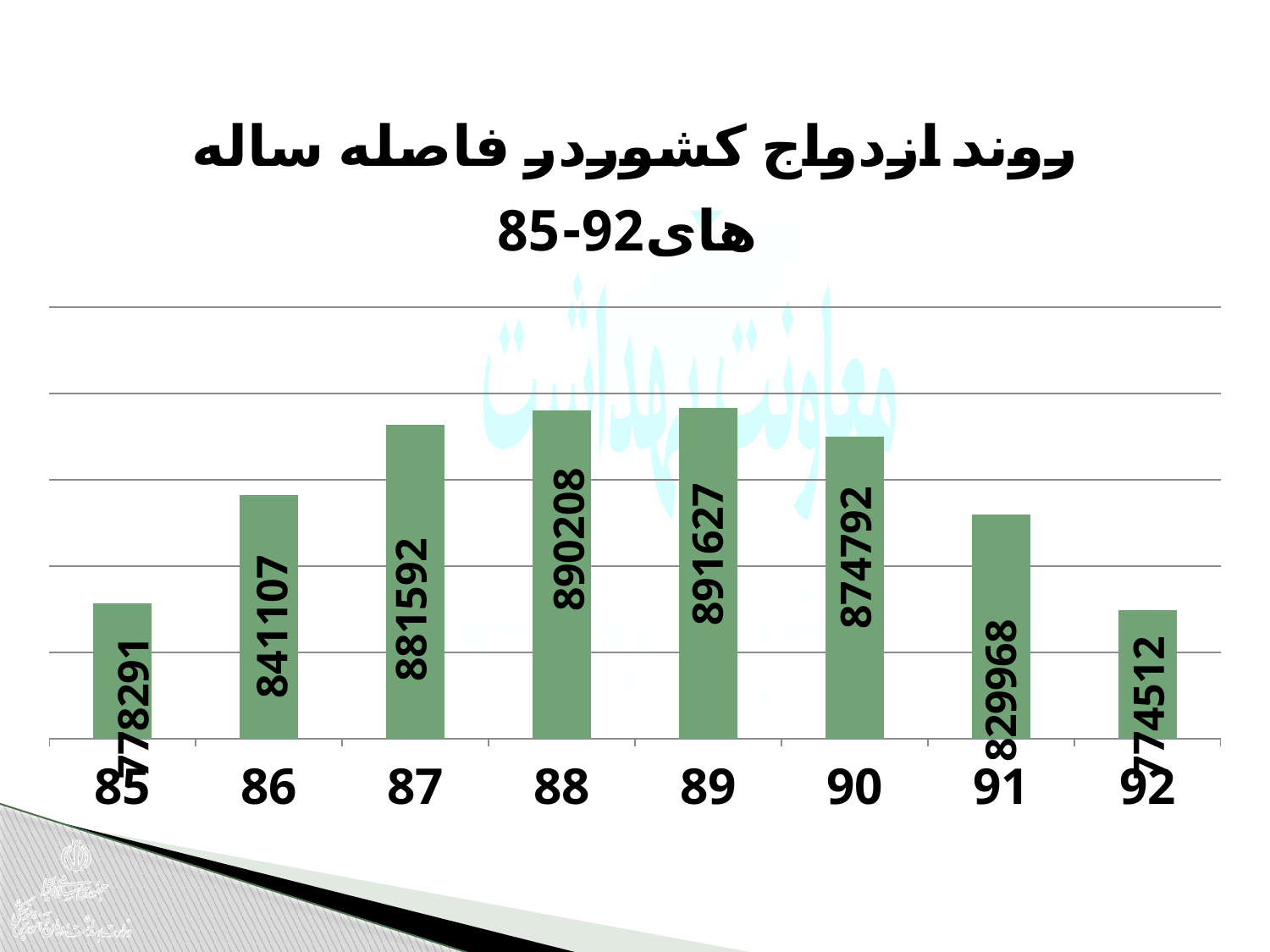
What is the value for year 88? 890208 Do the values rise or fall from year 85 to year 89? rise Which is larger, the value for year 90 or the value for year 91? 90 What is the difference between the values for years 87 and 86? 40485 What is the value for year 91? 829968 What is the difference between the values for years 89 and 88? 1419 What is the value for year 85? 778291 How many years are shown on the x axis? 8 Which year has the lowest value? 92 What kind of chart is this? bar chart Do the values rise or fall from year 89 to year 92? fall Which year has the highest value? 89